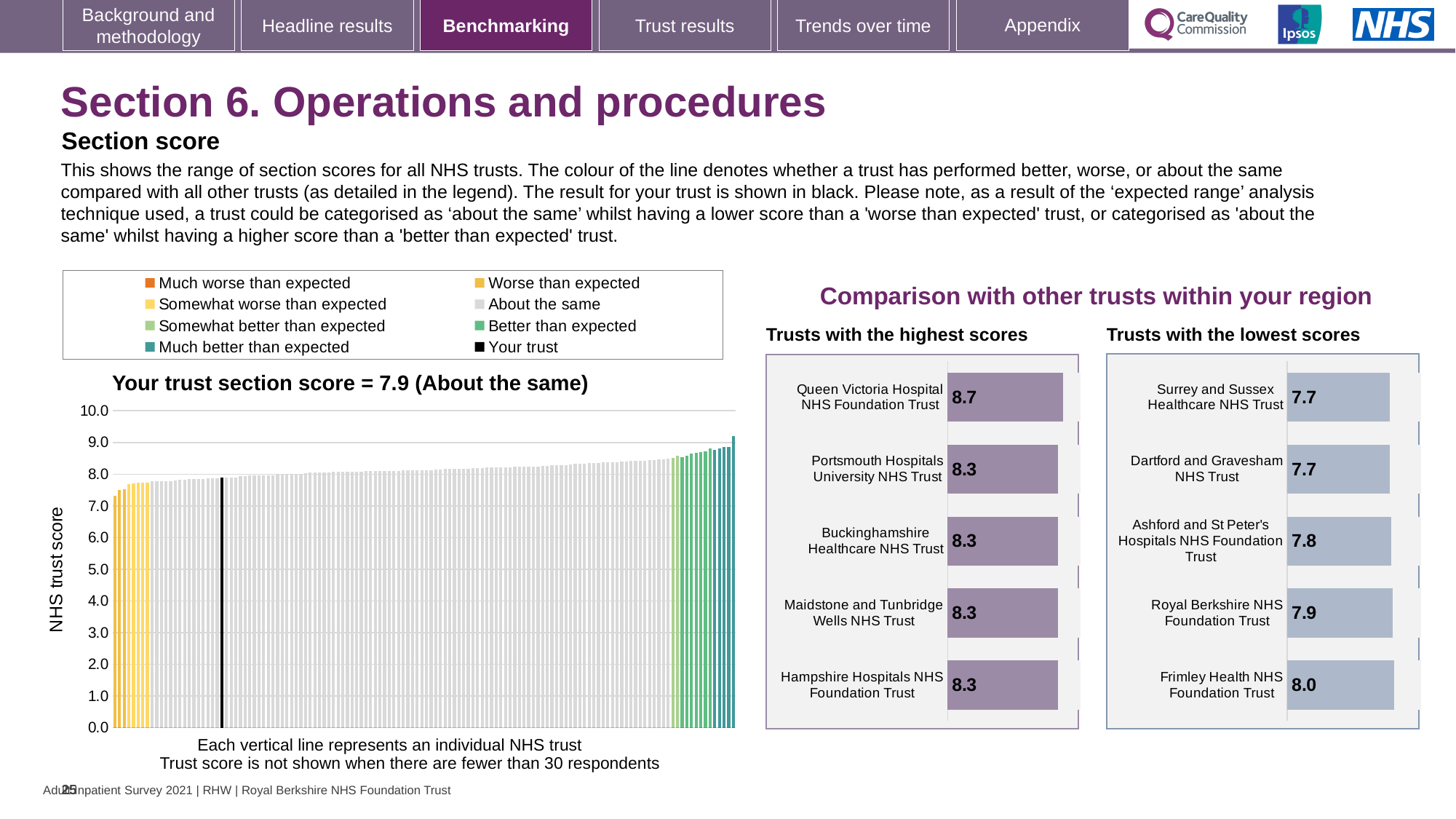
How many trusts are shown in the 'Trusts with the lowest scores' chart? 5 In the 'Trusts with the highest scores' chart, which trust has the highest score? Queen Victoria Hospital NHS Foundation Trust In the 'Trusts with the highest scores' chart, what is the score for Queen Victoria Hospital NHS Foundation Trust? 8.7 How many entries does the legend above the main chart on the left list? 8 In the 'Trusts with the lowest scores' chart, what is the score for Frimley Health NHS Foundation Trust? 8.0 In the 'Trusts with the lowest scores' chart, what is the score for Ashford and St Peter's Hospitals NHS Foundation Trust? 7.8 In the 'Trusts with the highest scores' chart, what is the difference between the scores of Queen Victoria Hospital NHS Foundation Trust and Portsmouth Hospitals University NHS Trust? 0.4 In the main chart on the left, is the value of the lowest-scoring trust greater or less than 7.0? greater In the 'Trusts with the lowest scores' chart, which is larger: the score for Royal Berkshire NHS Foundation Trust or the score for Surrey and Sussex Healthcare NHS Trust? Royal Berkshire NHS Foundation Trust In the 'Trusts with the lowest scores' chart, which trust has the highest score? Frimley Health NHS Foundation Trust In the 'Trusts with the highest scores' chart, what is the score for Maidstone and Tunbridge Wells NHS Trust? 8.3 In the main chart on the left, what is the section score for your trust? 7.9